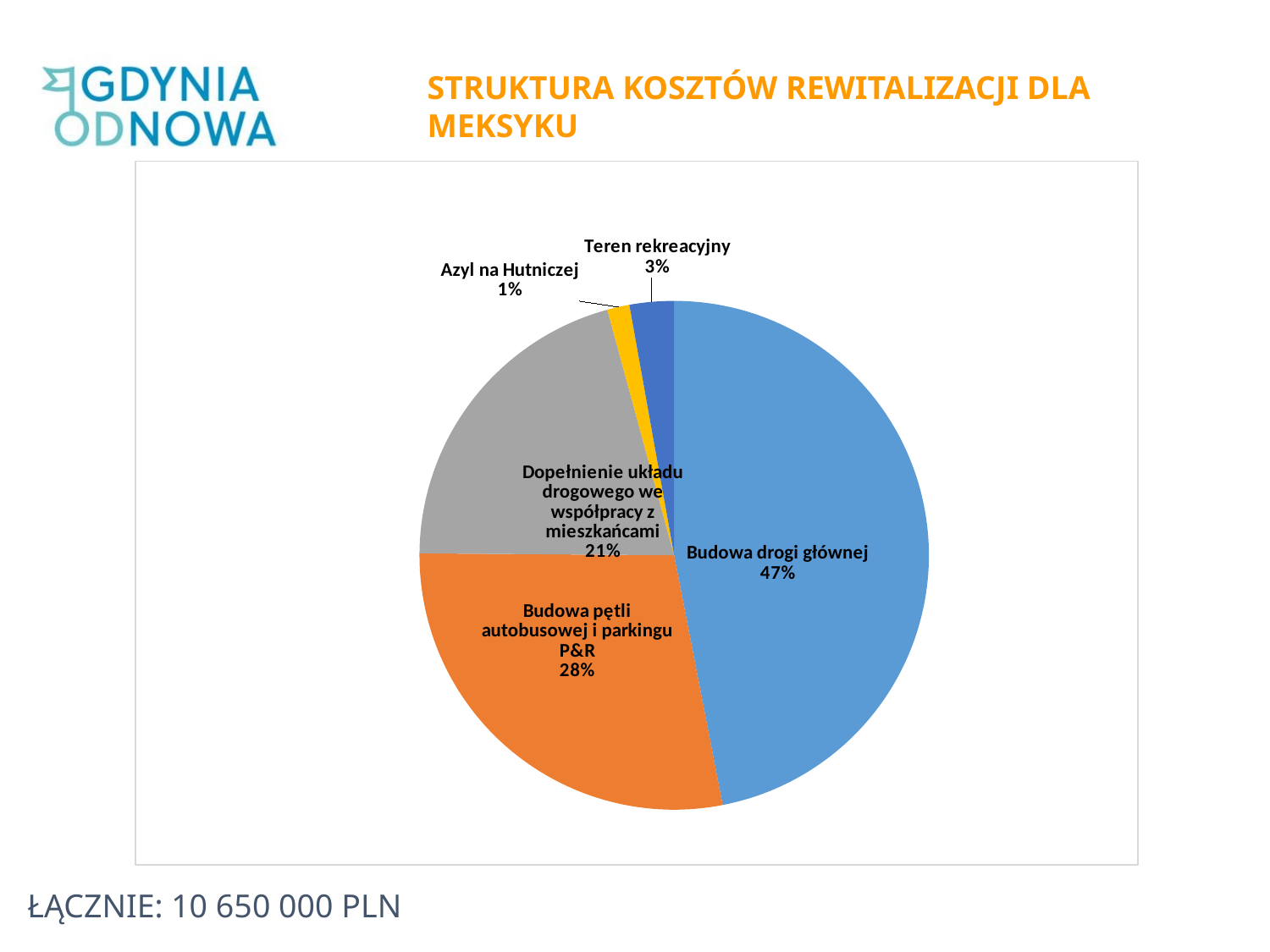
What is the title of the chart on the slide? STRUKTURA KOSZTÓW REWITALIZACJI DLA MEKSYKU What share of the pie does "Budowa drogi głównej" represent? 47% Which category has the largest slice of the pie? Budowa drogi głównej What share of the pie does "Teren rekreacyjny" represent? 3% How many categories are shown in the pie chart? 5 What share of the pie does "Dopełnienie układu drogowego we współpracy z mieszkańcami" represent? 21% Which is larger: the share for "Dopełnienie układu drogowego we współpracy z mieszkańcami" or the share for "Teren rekreacyjny"? Dopełnienie układu drogowego we współpracy z mieszkańcami What is the difference in percentage points between "Budowa drogi głównej" and "Budowa pętli autobusowej i parkingu P&R"? 19 percentage points Which category has the smallest slice of the pie? Azyl na Hutniczej What kind of chart is shown on the slide? pie chart